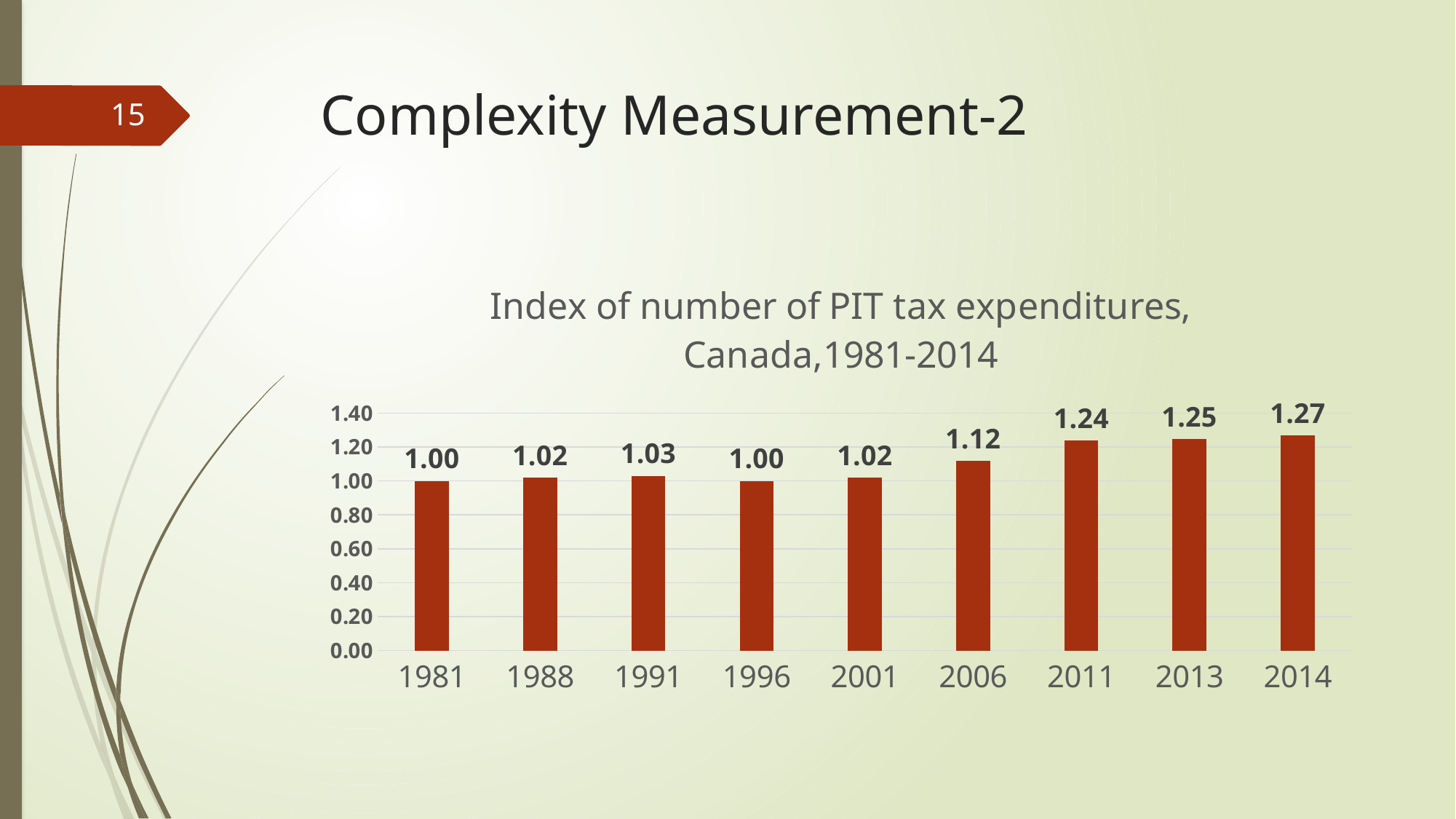
What is the index value for 1991? 1.03 What is the difference between the index values for 2014 and 1981? 0.27 How many years are shown on the x axis? 9 What kind of chart is shown on the slide? Bar chart What is the title of the chart? Index of number of PIT tax expenditures, Canada,1981-2014 Is the index value for 2013 greater or less than 1.20? greater Which is larger, the index value for 2006 or for 2011? 2011 What is the index value for 2014? 1.27 What is the difference between the index values for 2011 and 2006? 0.12 Do the index values generally rise or fall from 2001 to 2014? Rise What is the index value for 2006? 1.12 Which year has the highest index value? 2014